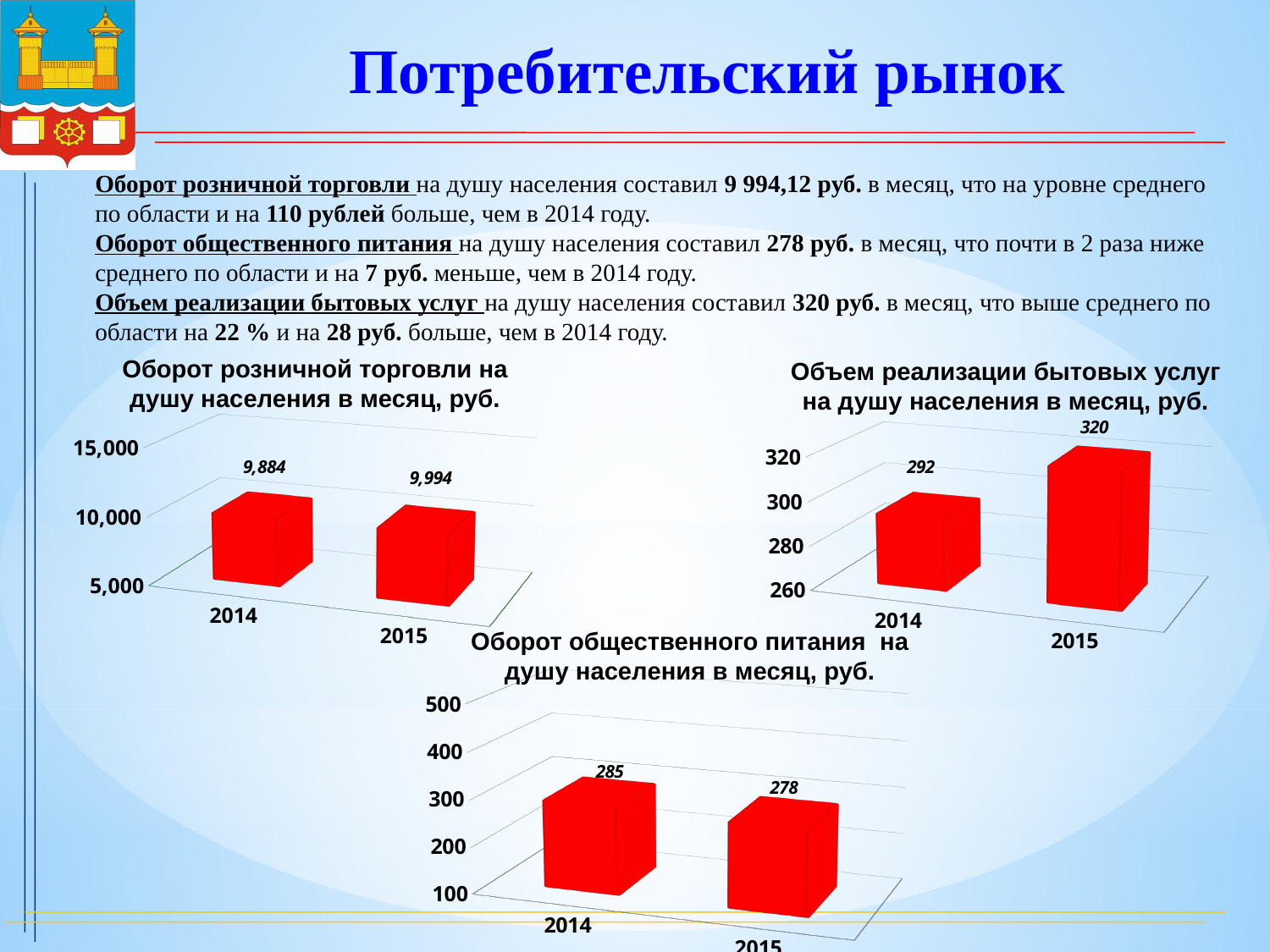
In the chart 'Оборот общественного питания на душу населения в месяц, руб.', is the value for 2014 greater or less than 300? less In the chart 'Оборот общественного питания на душу населения в месяц, руб.', do the values rise or fall from 2014 to 2015? fall In the chart 'Оборот розничной торговли на душу населения в месяц, руб.', what is the value for 2015? 9,994 In the chart 'Оборот розничной торговли на душу населения в месяц, руб.', what is the value for 2014? 9,884 In the chart 'Объем реализации бытовых услуг на душу населения в месяц, руб.', what is the value for 2014? 292 In the chart 'Объем реализации бытовых услуг на душу населения в месяц, руб.', by how much did the value increase from 2014 to 2015? 28 In the chart 'Объем реализации бытовых услуг на душу населения в месяц, руб.', which year has the highest value? 2015 In the chart 'Оборот общественного питания на душу населения в месяц, руб.', which year has the lowest value? 2015 How many categories (years) are shown in the chart 'Оборот розничной торговли на душу населения в месяц, руб.'? 2 What kind of chart is 'Объем реализации бытовых услуг на душу населения в месяц, руб.'? bar chart In the chart 'Оборот общественного питания на душу населения в месяц, руб.', what is the value for 2015? 278 In the chart 'Оборот розничной торговли на душу населения в месяц, руб.', what is the difference between the 2015 and 2014 values? 110